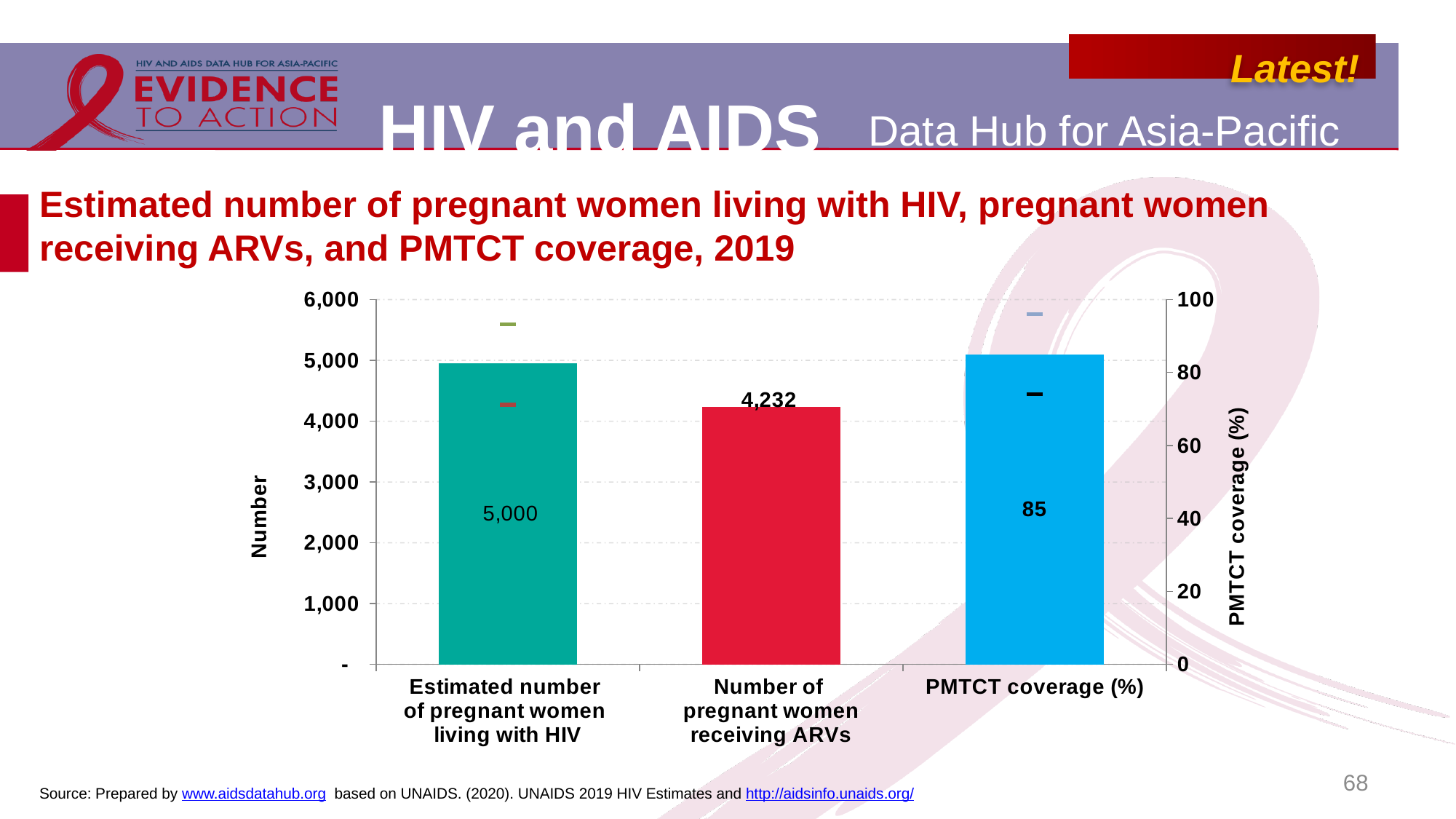
What is the maximum value shown on the right-hand axis of the chart? 100 What is the number of pregnant women receiving ARVs shown on the chart? 4,232 What is the title of the left vertical axis of the chart? Number What is the PMTCT coverage (%) value shown on the chart? 85 What is the difference between the estimated number of pregnant women living with HIV and the number of pregnant women receiving ARVs? 768 Is the number of pregnant women receiving ARVs greater or less than 5,000? less How many bars are plotted on the chart? 3 What is the estimated number of pregnant women living with HIV shown on the chart? 5,000 Which is larger: the estimated number of pregnant women living with HIV or the number of pregnant women receiving ARVs? Estimated number of pregnant women living with HIV What kind of chart is shown on the slide? Bar chart What is the title of the right vertical axis of the chart? PMTCT coverage (%) Is the PMTCT coverage (%) value greater or less than 80 on the right-hand axis? greater